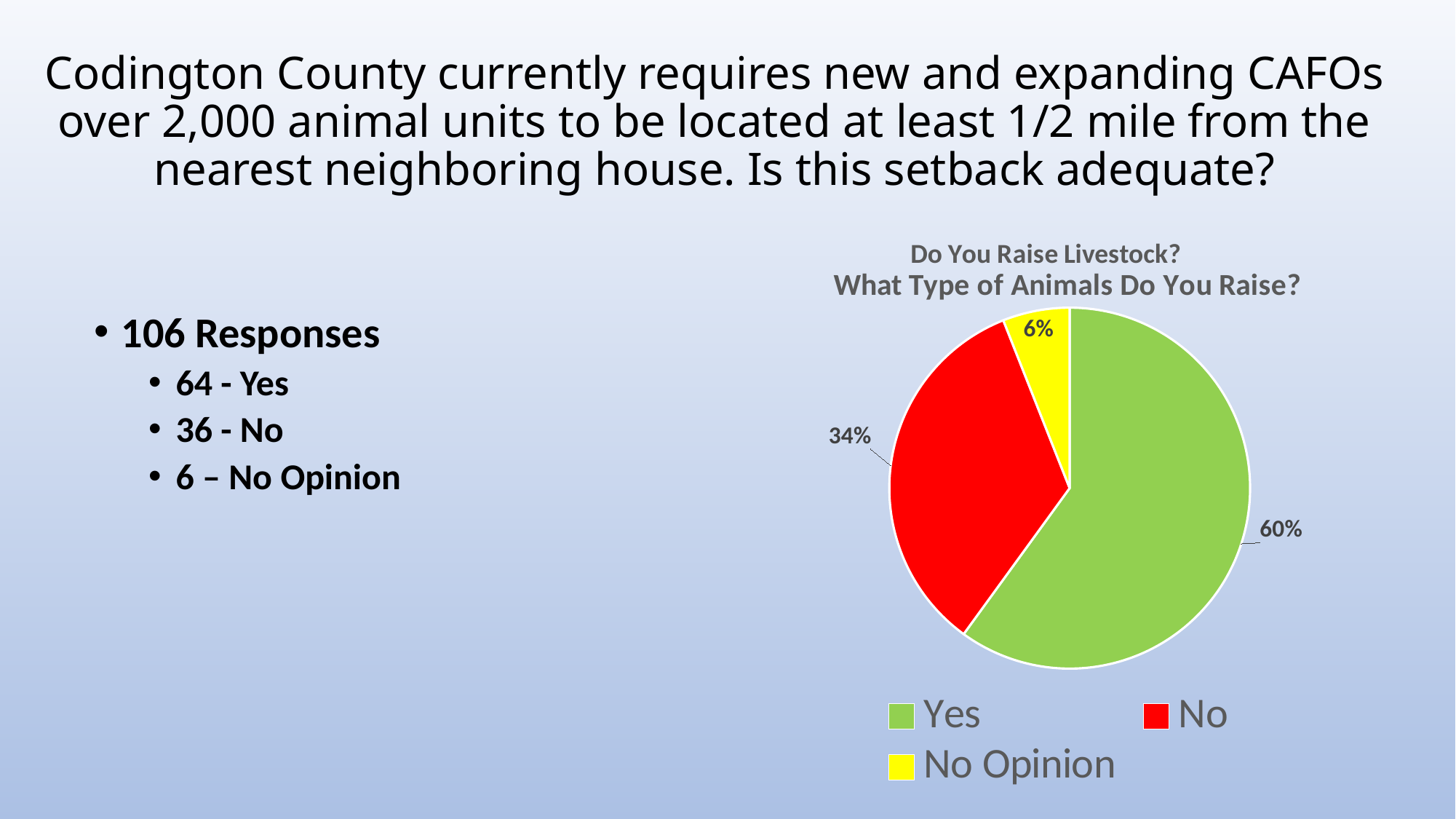
What colour is the No slice in the pie chart? Red Which is larger in the pie chart, the No slice or the No Opinion slice? No How many entries does the pie chart's legend list? 3 What is the difference in percentage points between the Yes slice and the No slice? 26 percentage points Which slice of the pie chart is the largest? Yes Which slice of the pie chart is the smallest? No Opinion What percentage of the pie chart is the No slice? 34% What type of chart is shown on the slide? Pie chart What percentage of the pie chart is the No Opinion slice? 6% What percentage of the pie chart is the Yes slice? 60% How many slices does the pie chart have? 3 What is the title of the pie chart? Do You Raise Livestock? What Type of Animals Do You Raise?